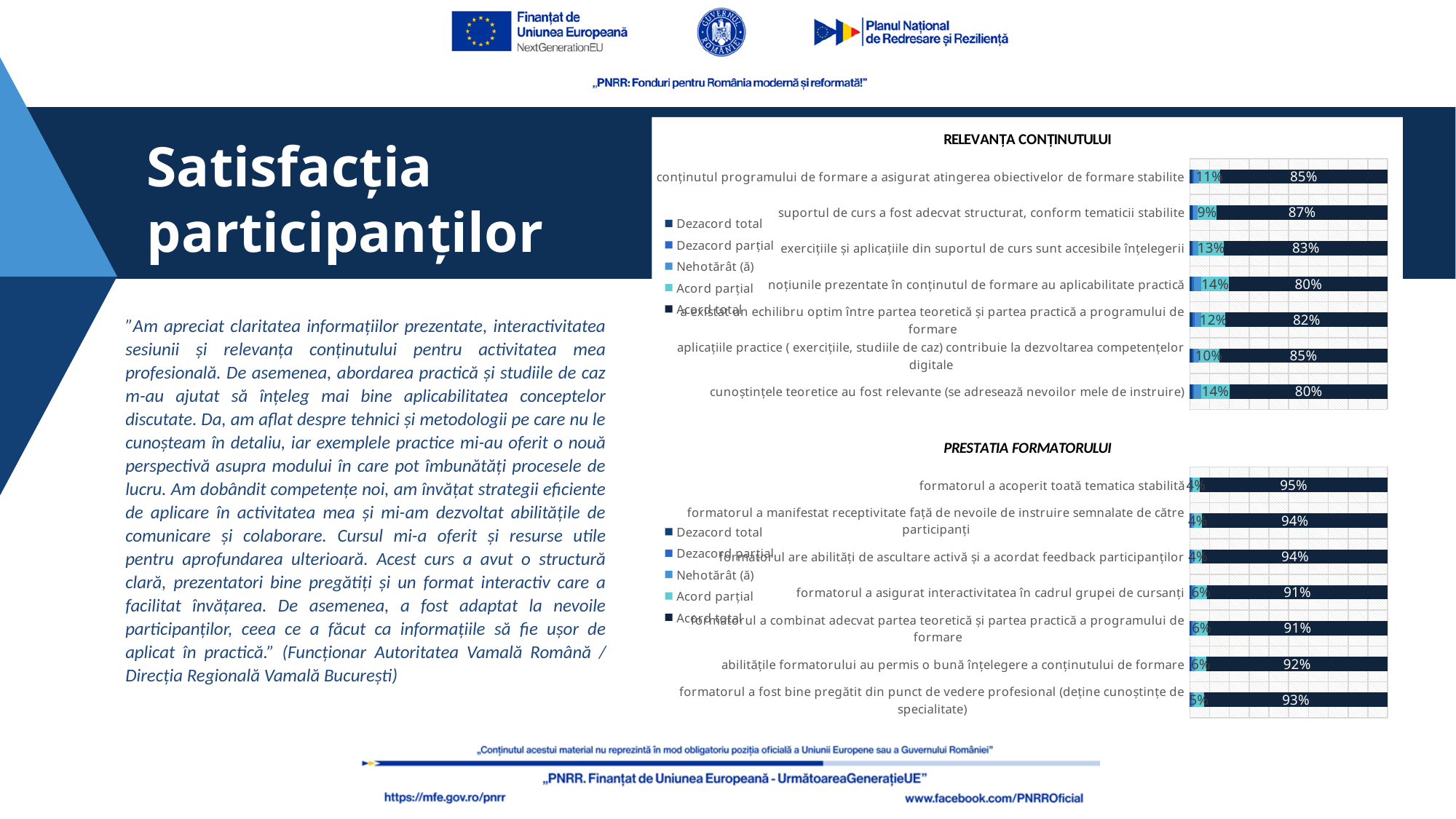
In the 'RELEVANȚA CONȚINUTULUI' chart, which statement has the highest 'Acord total' value? suportul de curs a fost adecvat structurat, conform tematicii stabilite What kind of chart is the 'PRESTATIA FORMATORULUI' chart? Stacked bar chart In the 'RELEVANȚA CONȚINUTULUI' chart, what is the difference between the 'Acord total' values for 'suportul de curs a fost adecvat structurat' and 'exercițiile și aplicațiile din suportul de curs sunt accesibile înțelegerii'? 4% In the 'PRESTATIA FORMATORULUI' chart, what is the 'Acord parțial' value for 'formatorul a fost bine pregătit din punct de vedere profesional'? 5% What is the title of the lower chart on the slide? PRESTATIA FORMATORULUI How many series does the legend of the 'RELEVANȚA CONȚINUTULUI' chart list? 5 In the 'PRESTATIA FORMATORULUI' chart, which statement has the highest 'Acord total' value? formatorul a acoperit toată tematica stabilită In the 'RELEVANȚA CONȚINUTULUI' chart, what is the 'Acord parțial' value for 'noțiunile prezentate în conținutul de formare au aplicabilitate practică'? 14% In the 'RELEVANȚA CONȚINUTULUI' chart, how many statements (categories) are shown? 7 In the 'PRESTATIA FORMATORULUI' chart, what is the 'Acord total' value for 'formatorul a acoperit toată tematica stabilită'? 95% In the 'PRESTATIA FORMATORULUI' chart, which is larger: the 'Acord total' value for 'abilitățile formatorului au permis o bună înțelegere a conținutului de formare' or for 'formatorul a asigurat interactivitatea în cadrul grupei de cursanți'? abilitățile formatorului au permis o bună înțelegere a conținutului de formare In the 'RELEVANȚA CONȚINUTULUI' chart, what is the 'Acord total' value for 'suportul de curs a fost adecvat structurat, conform tematicii stabilite'? 87%